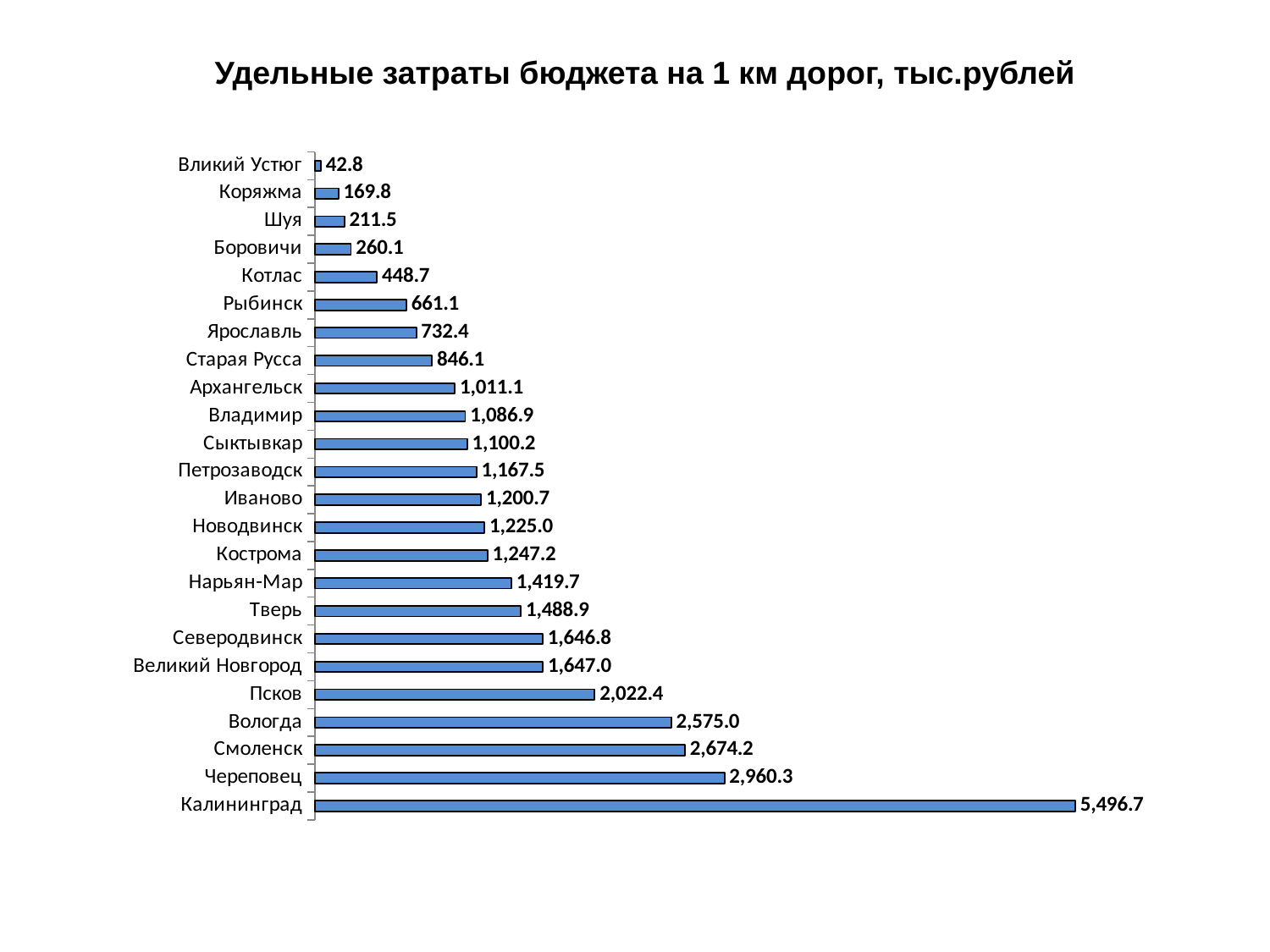
What is the difference between the values for Вологда and Псков? 552.6 What is the value for Ярославль? 732.4 What type of chart is shown on the slide? bar chart What is the difference between the values for Калининград and Череповец? 2,536.4 Which city has the highest value? Калининград What is the value for Нарьян-Мар? 1,419.7 Which has the larger value, Тверь or Нарьян-Мар? Тверь What is the value for Калининград? 5,496.7 Which city has the lowest value? Вликий Устюг What is the title of the chart? Удельные затраты бюджета на 1 км дорог, тыс.рублей How many cities are shown in the chart? 24 Which has the larger value, Смоленск or Вологда? Смоленск